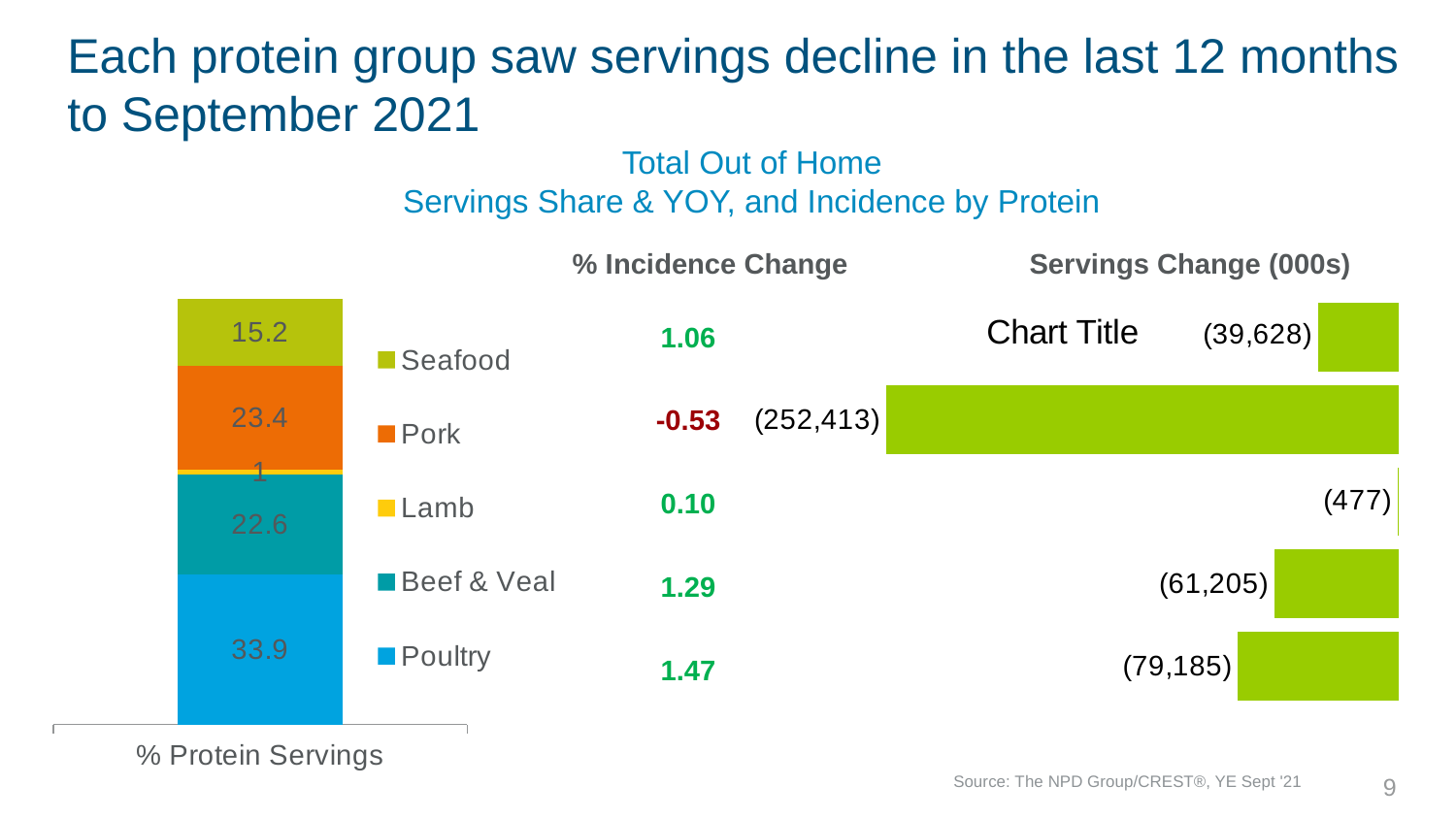
In the left stacked bar chart (% Protein Servings), what is the value for Seafood? 15.2 What type of chart is the left chart labelled % Protein Servings? Stacked bar chart In the left stacked bar chart (% Protein Servings), what is the difference between the Poultry and Beef & Veal values? 11.3 In the left stacked bar chart (% Protein Servings), which protein has the largest share of servings? Poultry In the right chart (Servings Change (000s)), what is the value for Pork? (252,413) In the left stacked bar chart (% Protein Servings), what is the value for Poultry? 33.9 In the left stacked bar chart (% Protein Servings), which protein has the smallest share of servings? Lamb In the right chart (Servings Change (000s)), what is the value for Lamb? (477) In the right chart (Servings Change (000s)), is the bar for Poultry or for Beef & Veal longer? Poultry In the left stacked bar chart (% Protein Servings), what is the value for Pork? 23.4 In the left stacked bar chart (% Protein Servings), how many series does the legend list? 5 In the right chart (Servings Change (000s)), which protein has the longest bar, i.e. the largest servings decline? Pork